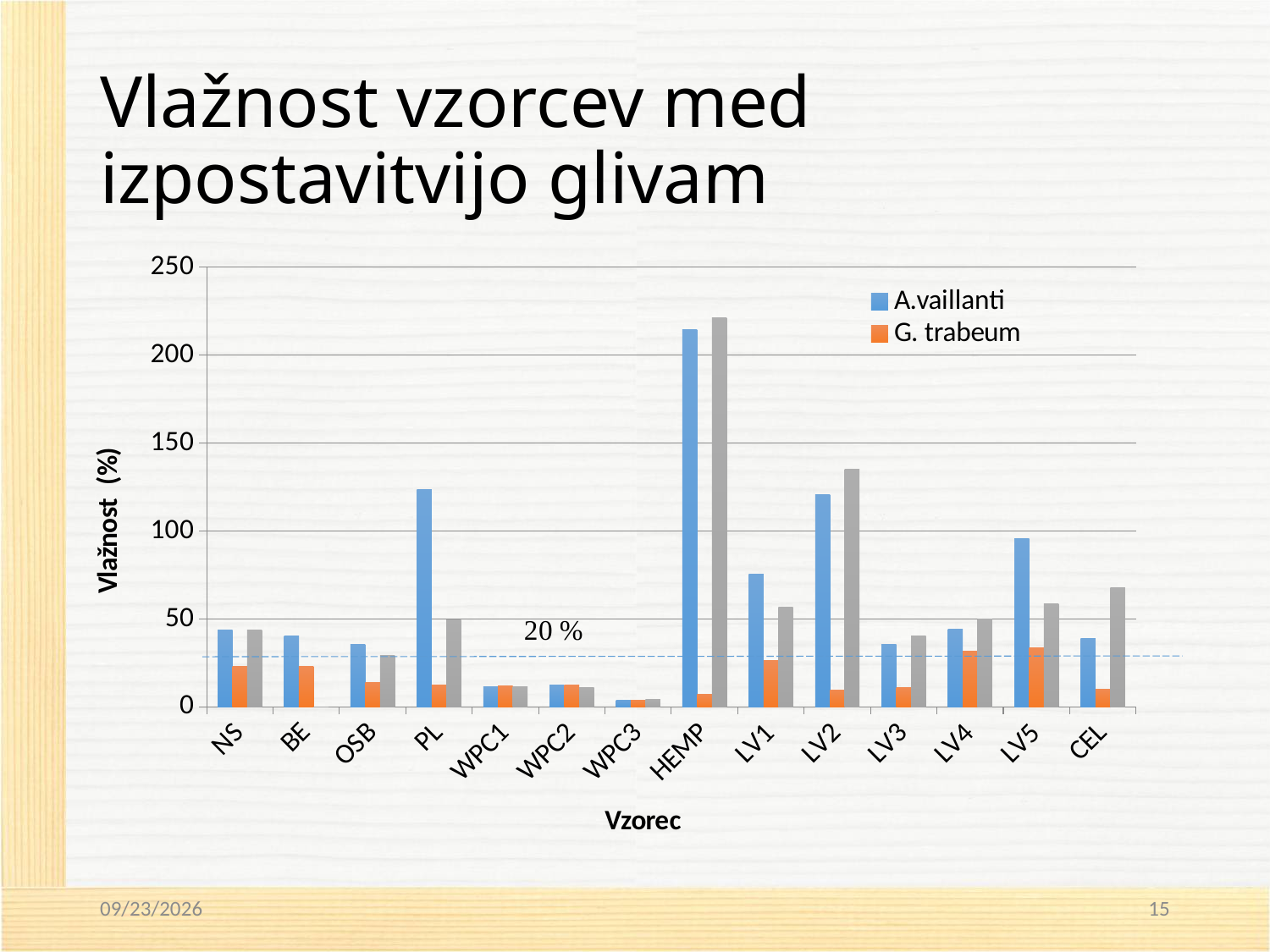
Which category has the highest A.vaillanti value? HEMP Is the G. trabeum value for NS greater or less than 50? less How many categories are shown on the x axis of the chart? 14 What is the label of the chart's y axis? Vlažnost (%) How many series does the chart's legend list? 2 Is the A.vaillanti value for PL greater or less than 100? greater Which category has the lowest A.vaillanti value? WPC3 Is the A.vaillanti value for LV5 greater or less than 50? greater Which is larger, the G. trabeum value for LV5 or for WPC3? LV5 What kind of chart is shown on the slide? bar chart Which is larger, the A.vaillanti value for PL or for LV1? PL